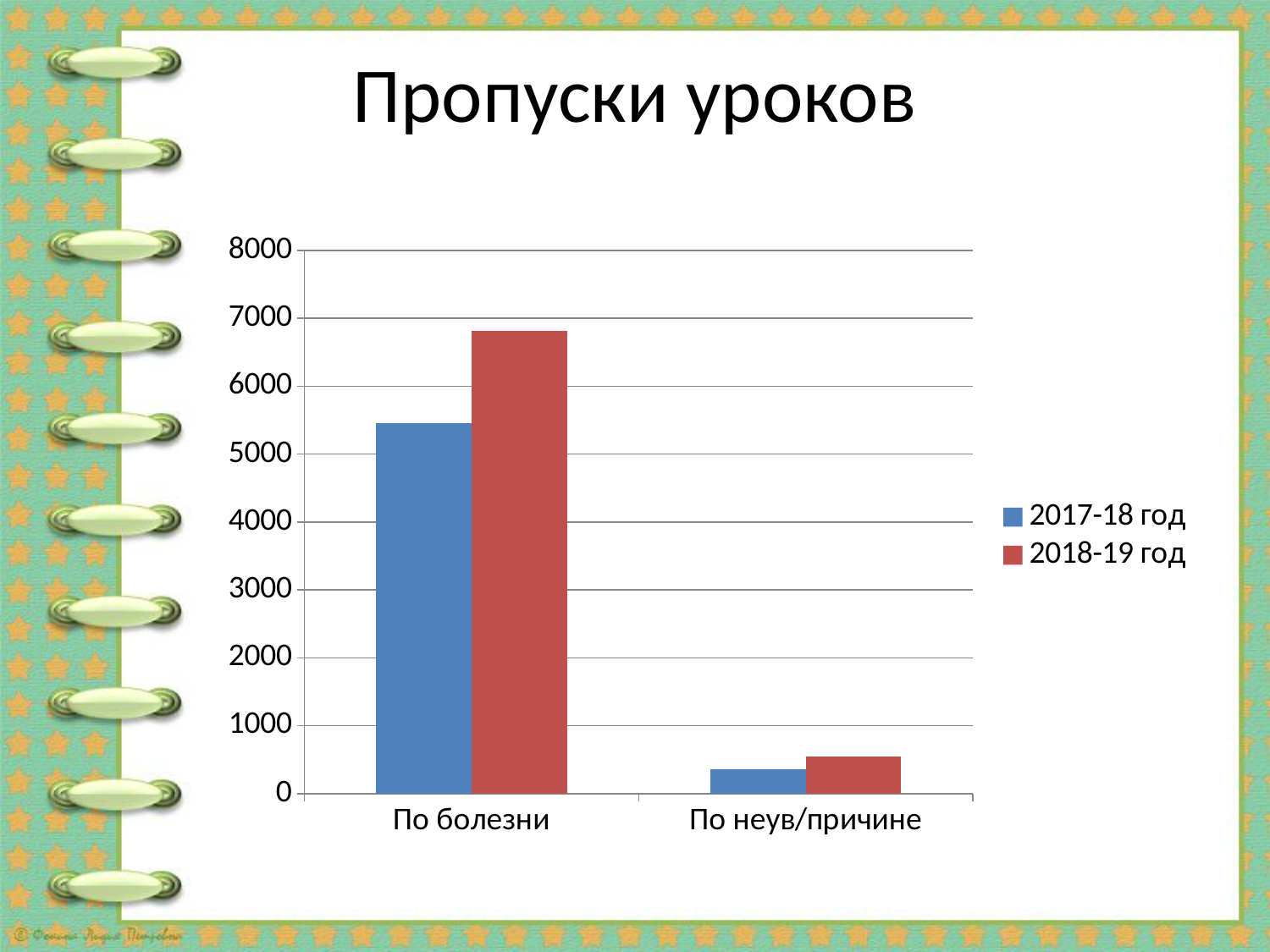
Is the value for 2018-19 год in По болезни greater or less than 6000? greater Which colour represents the 2018-19 год series? red How many series does the legend list? 2 Which category has the lowest bar in the chart? По неув/причине Is the value for 2018-19 год in По неув/причине greater or less than 1000? less What kind of chart is shown on the slide? bar chart How many categories are shown on the x axis? 2 Which category has the highest bar in the chart? По болезни What is the title of the chart? Пропуски уроков Is the value for 2017-18 год in По болезни greater or less than 6000? less For По болезни, which series has the larger value: 2017-18 год or 2018-19 год? 2018-19 год For По неув/причине, which series has the larger value: 2017-18 год or 2018-19 год? 2018-19 год